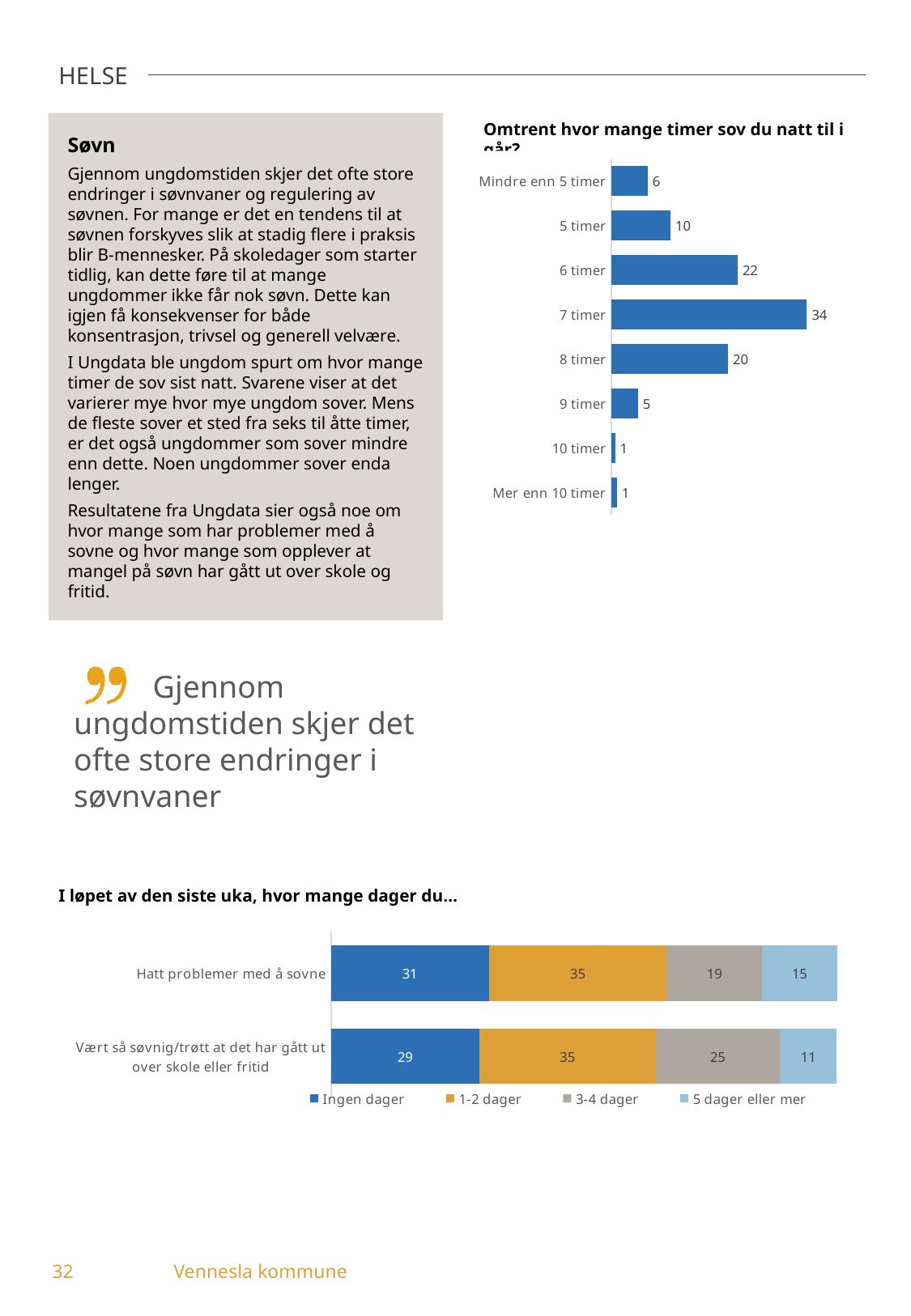
In the bottom chart "I løpet av den siste uka, hvor mange dager du…", what is the total of the "Hatt problemer med å sovne" bar? 100 In the bottom chart "I løpet av den siste uka, hvor mange dager du…", what is the value for "1-2 dager" in the "Hatt problemer med å sovne" bar? 35 How many categories are shown in the top-right chart about hours slept last night? 8 In the bottom chart "I løpet av den siste uka, hvor mange dager du…", which colour represents "3-4 dager"? Grey In the top-right chart about hours slept last night, which category has the highest value? 7 timer In the top-right chart about hours slept last night, what is the value for "7 timer"? 34 In the top-right chart about hours slept last night, what is the difference between the values for "6 timer" and "8 timer"? 2 In the top-right chart about hours slept last night, what is the value for "Mindre enn 5 timer"? 6 In the bottom chart "I løpet av den siste uka, hvor mange dager du…", what is the value for "5 dager eller mer" in the "Vært så søvnig/trøtt at det har gått ut over skole eller fritid" bar? 11 What kind of chart is the top-right chart about hours slept last night? Bar chart How many series does the legend of the bottom chart "I løpet av den siste uka, hvor mange dager du…" list? 4 In the top-right chart about hours slept last night, which is larger: the value for "5 timer" or the value for "9 timer"? 5 timer